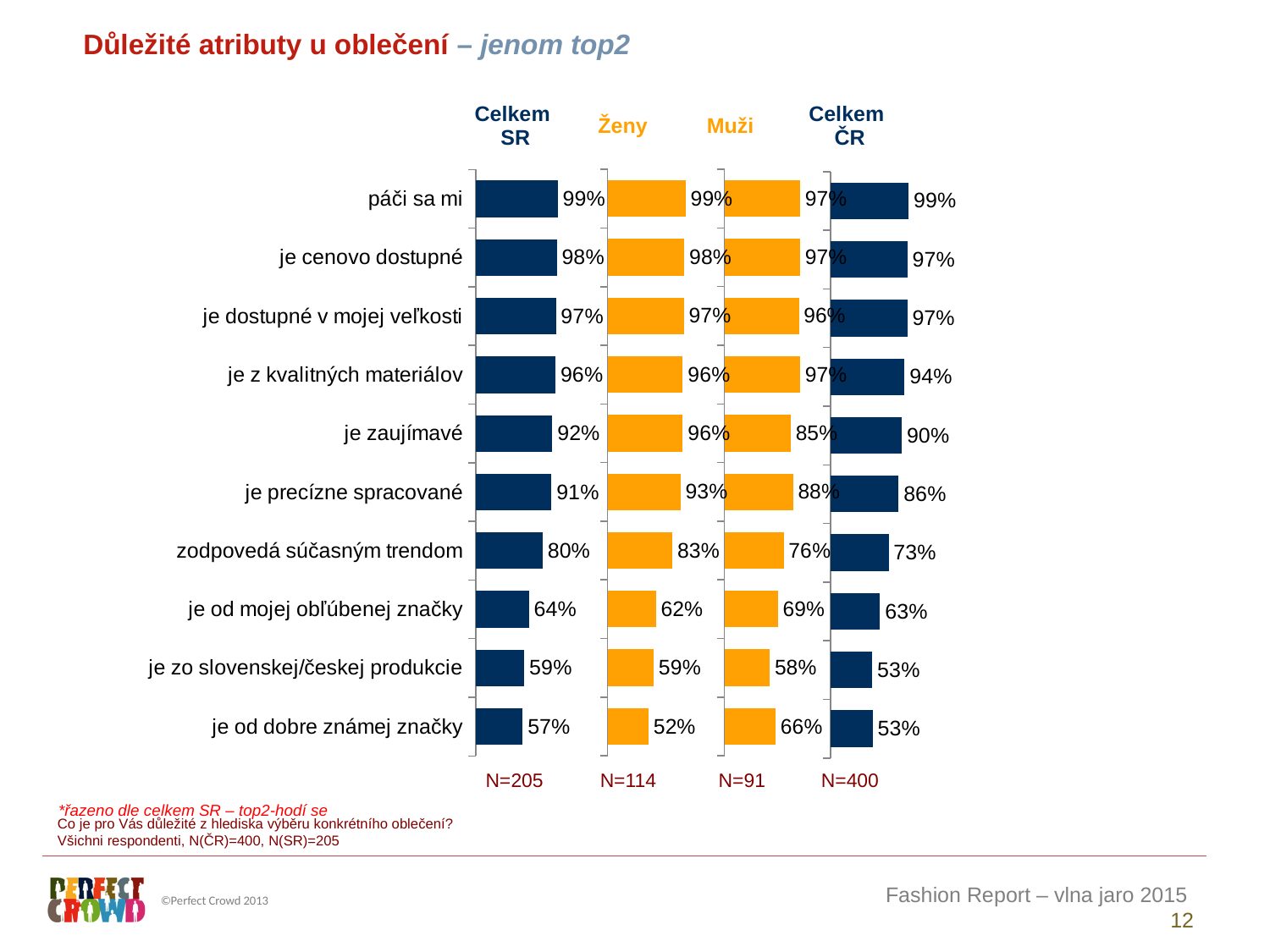
What type of chart is used on this slide? Bar chart In the Muži chart, what is the value for "je od dobre známej značky"? 66% In the Celkem SR chart, what is the value for "je zaujímavé"? 92% In the Celkem ČR chart, what is the difference between "páči sa mi" and "zodpovedá súčasným trendom"? 26% What is the sample size (N) shown under the Celkem ČR chart? N=400 In the Celkem SR chart, which attribute has the lowest value? je od dobre známej značky In the Ženy chart, what is the value for "zodpovedá súčasným trendom"? 83% How many attributes are listed in each chart? 10 In the Muži chart, which attribute has the lowest value? je zo slovenskej/českej produkcie For "je od mojej obľúbenej značky", which is larger: the Muži value or the Ženy value? Muži In the Celkem ČR chart, what is the value for "je precízne spracované"? 86% In the Ženy chart, which attribute has the lowest value? je od dobre známej značky